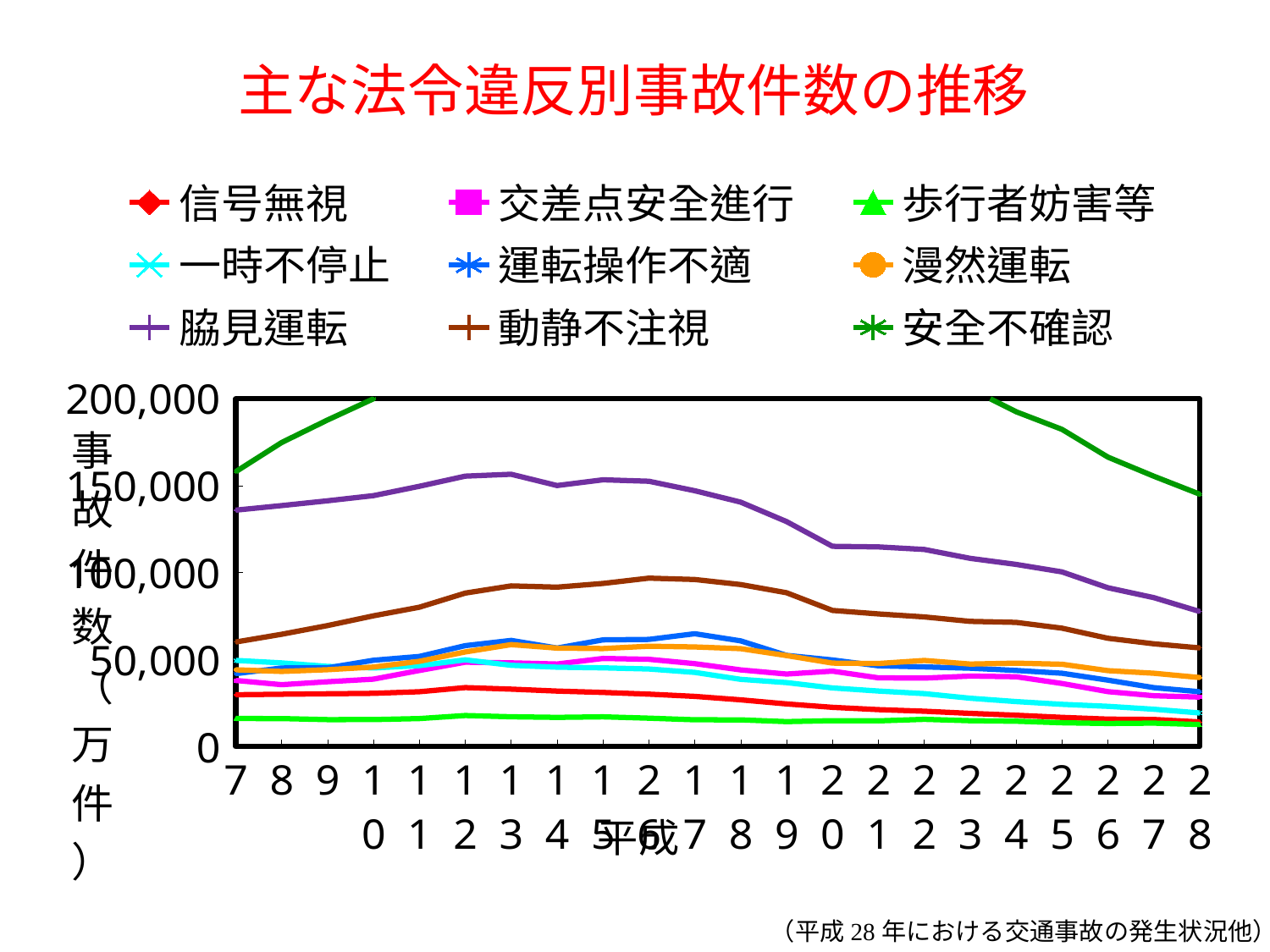
How many years (x-axis points) are plotted on the chart? 22 Does the value for 脇見運転 rise or fall from 平成20 to 平成28? fall What kind of chart is shown on the slide? line chart How many series does the legend list? 9 Which series has the highest value at 平成28? 安全不確認 Is the value for 動静不注視 at 平成28 greater or less than 100,000? less Which series has the lowest value at 平成28? 歩行者妨害等 What is the title of the chart? 主な法令違反別事故件数の推移 Which series is drawn in purple? 脇見運転 At 平成15, which is larger: 脇見運転 or 動静不注視? 脇見運転 Is the value for 信号無視 at 平成7 greater or less than 50,000? less Is the value for 脇見運転 at 平成7 greater or less than 100,000? greater